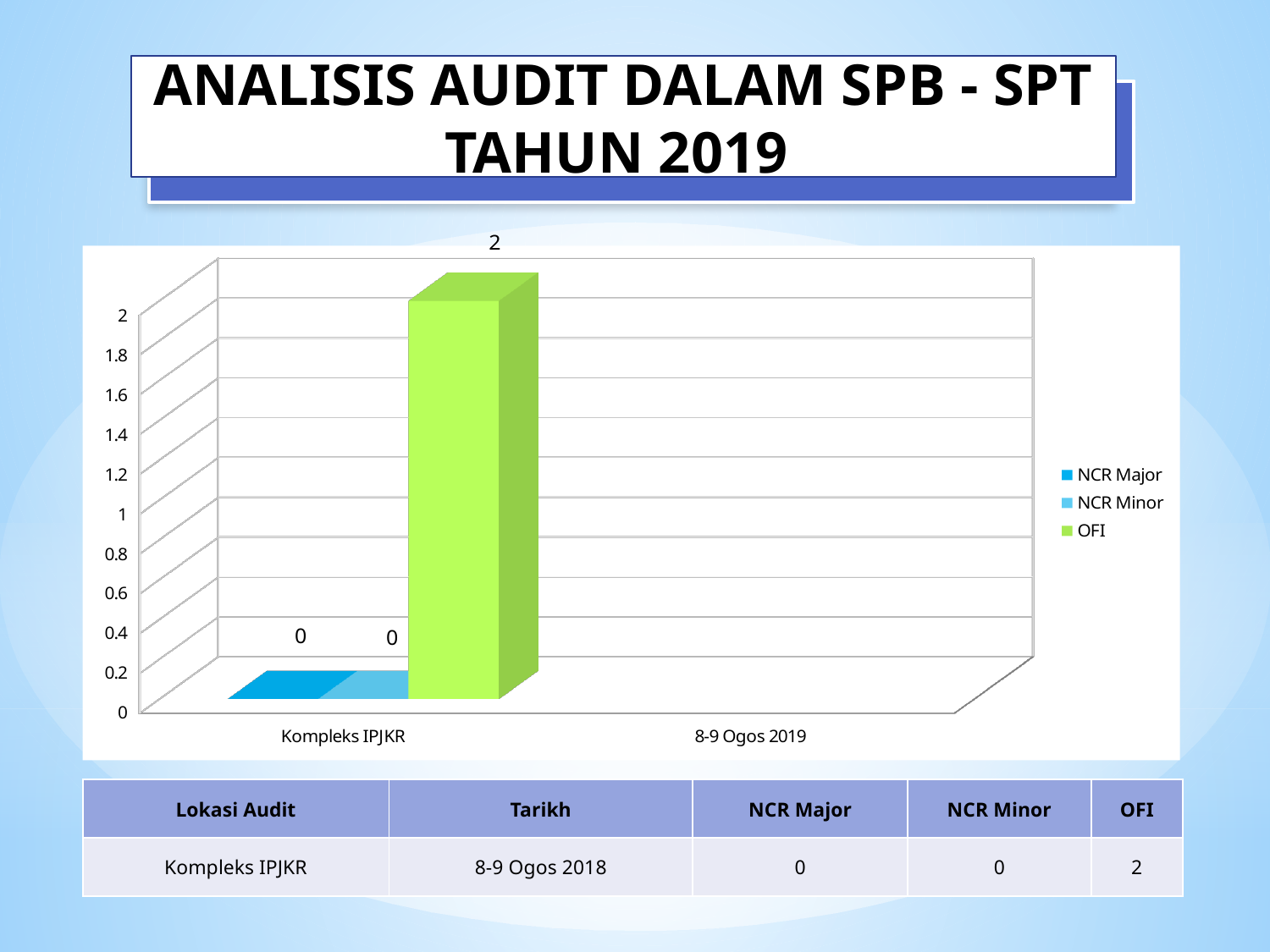
What is the difference between the OFI value and the NCR Major value for Kompleks IPJKR? 2 What is the value of the NCR Major bar for Kompleks IPJKR? 0 How many category labels are shown on the x axis? 2 Which is larger for Kompleks IPJKR, the OFI value or the NCR Minor value? OFI What colour represents the OFI series in the legend? green What are the three series names listed in the legend? NCR Major, NCR Minor, OFI What is the value of the OFI bar for Kompleks IPJKR? 2 What kind of chart is shown on the slide? bar chart What is the value of the NCR Minor bar for Kompleks IPJKR? 0 Is the OFI value for Kompleks IPJKR greater or less than 1? greater How many series does the legend list? 3 Which series has the highest value for Kompleks IPJKR? OFI